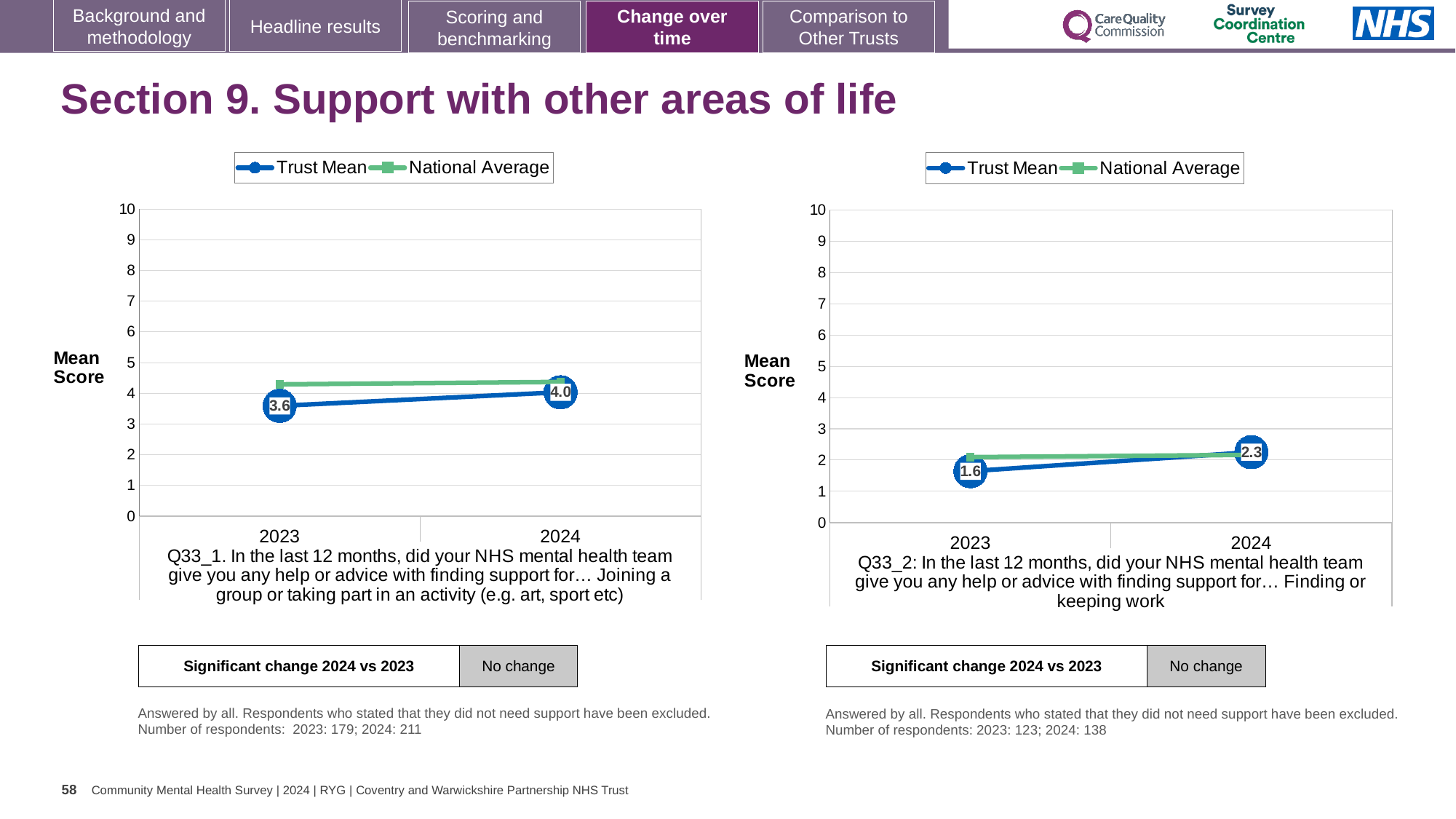
In the left chart (Q33_1), by how much did the Trust Mean change from 2023 to 2024? 0.4 In the left chart (Q33_1), in 2023 which is higher, the Trust Mean or the National Average? National Average How many series does the legend of the right chart (Q33_2) list? 2 In the right chart (Q33_2), what is the difference between the Trust Mean in 2024 and in 2023? 0.7 In the right chart (Q33_2), does the Trust Mean rise or fall from 2023 to 2024? rise What type of chart is the left chart (Q33_1)? line chart In the right chart (Q33_2), what is the Trust Mean score for 2024? 2.3 In the left chart (Q33_1), which year has the higher Trust Mean, 2023 or 2024? 2024 In the right chart (Q33_2), what is the Trust Mean score for 2023? 1.6 In the left chart (Q33_1), what is the Trust Mean score for 2024? 4.0 In the left chart (Q33_1), what is the Trust Mean score for 2023? 3.6 In the left chart (Q33_1), is the National Average for 2023 greater or less than 4? greater